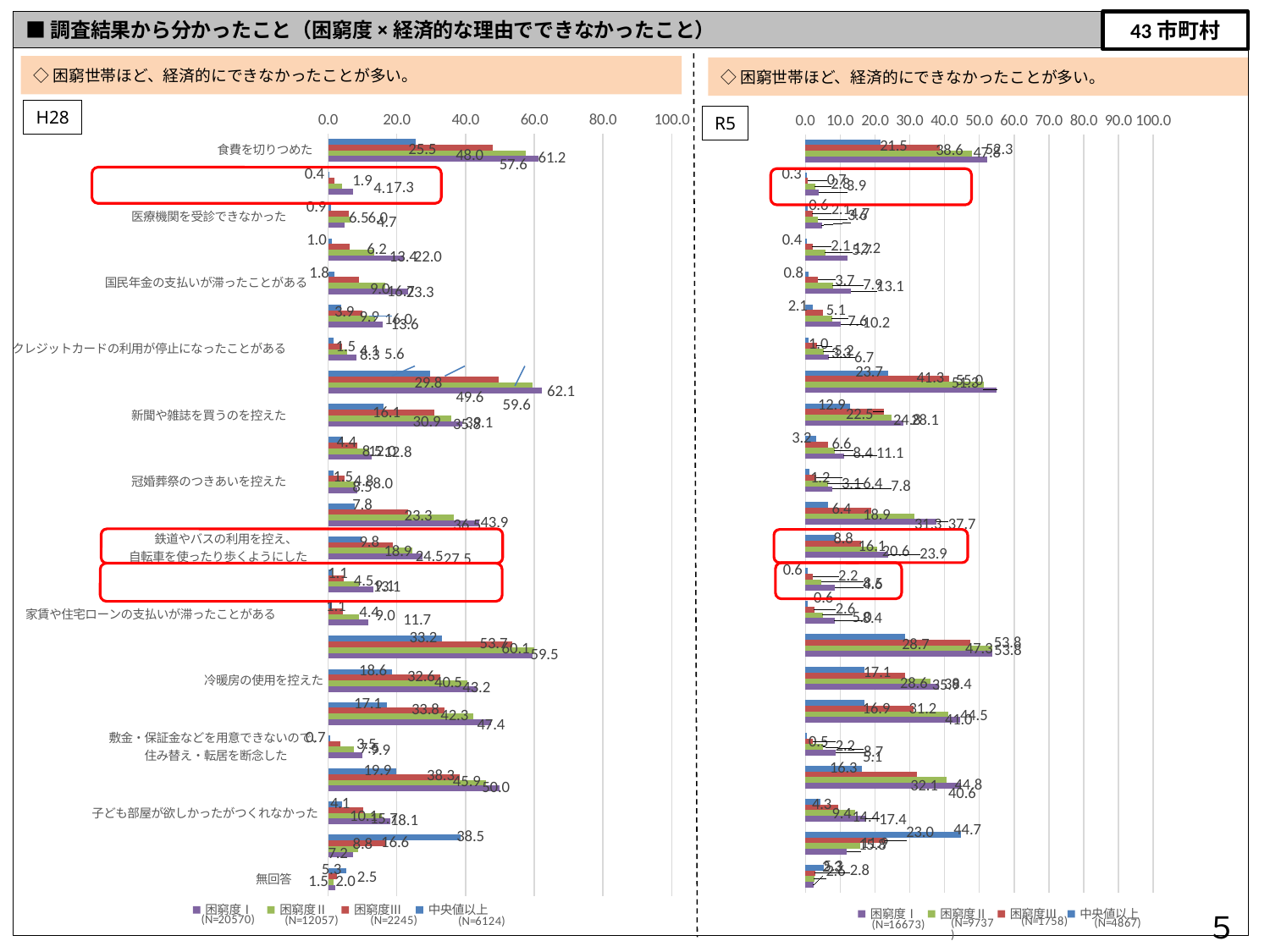
In the R5 chart, is the value for 困窮度Ⅰ for 食費を切りつめた greater or less than 50.0? greater In the H28 chart, what is the value for 困窮度Ⅲ for 食費を切りつめた? 48.0 How many series does the legend of the R5 chart list? 4 In the H28 chart, what is the difference between 困窮度Ⅰ and 中央値以上 for 食費を切りつめた? 35.7 In the H28 chart, for 鉄道やバスの利用を控え、自転車を使ったり歩くようにした, which is larger: 困窮度Ⅰ or 中央値以上? 困窮度Ⅰ In the H28 chart, what is the value for 中央値以上 for 食費を切りつめた? 25.5 In the R5 chart, what is the value for 中央値以上 for 食費を切りつめた? 21.5 In the R5 chart, what is the value for 困窮度Ⅲ for 食費を切りつめた? 38.6 In the H28 chart, which series has the highest value for 食費を切りつめた? 困窮度Ⅰ In the H28 chart, which series has the lowest value for 食費を切りつめた? 中央値以上 What kind of chart is the H28 chart on the left? bar chart In the H28 chart, what is the value for 困窮度Ⅰ for 食費を切りつめた? 61.2